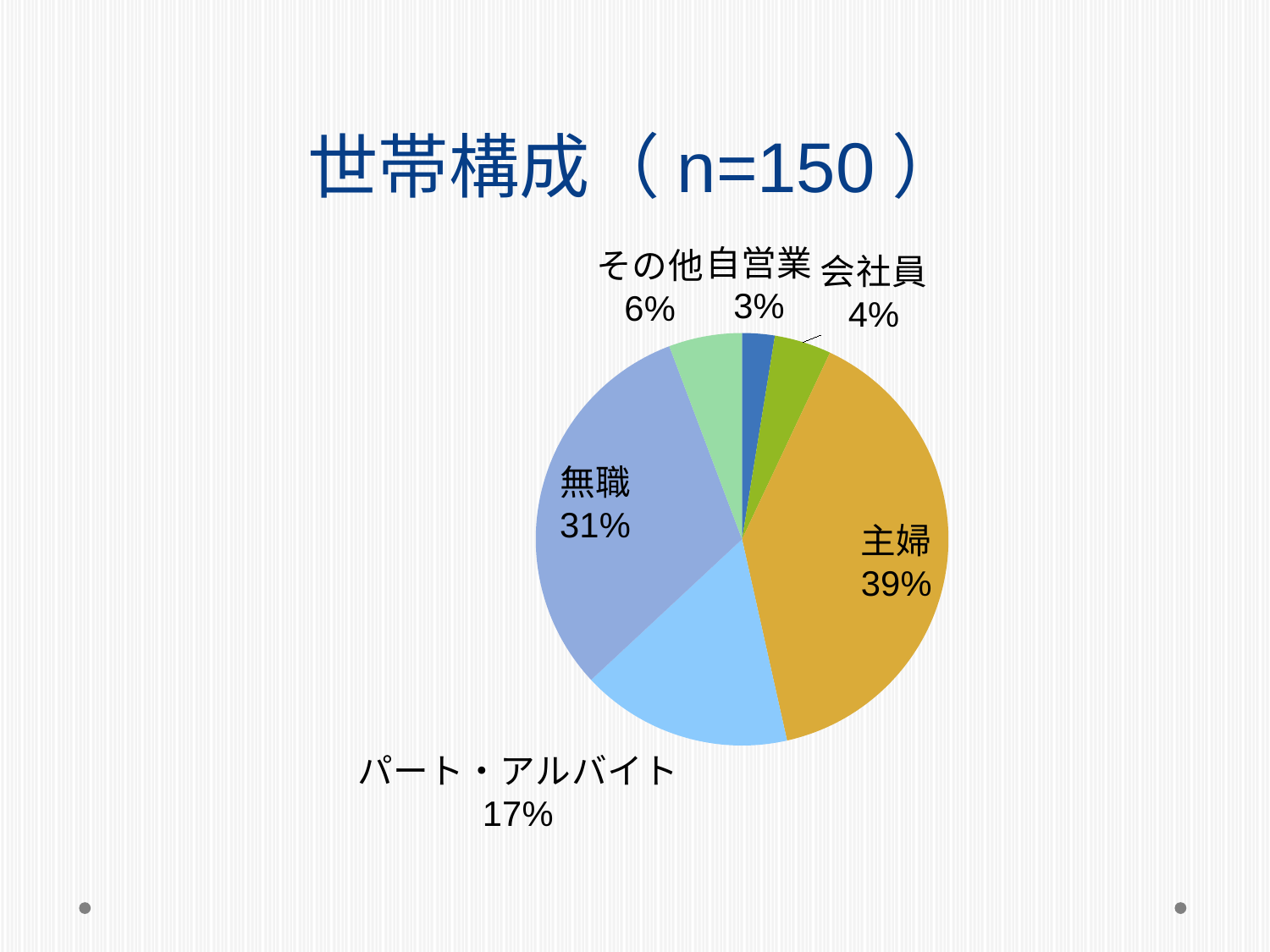
What is the value for 無職? 31% How many categories are shown in the pie chart? 6 Which category has the largest share of the pie? 主婦 What kind of chart is shown on the slide? pie chart What is the title of the chart? 世帯構成（n=150） Which category has the smallest share of the pie? 自営業 What is the value for 会社員? 4% What is the value for 自営業? 3% What is the value for その他? 6% What is the value for パート・アルバイト? 17% What is the difference between the shares of 主婦 and 無職? 8% What share of the pie does 主婦 account for? 39%